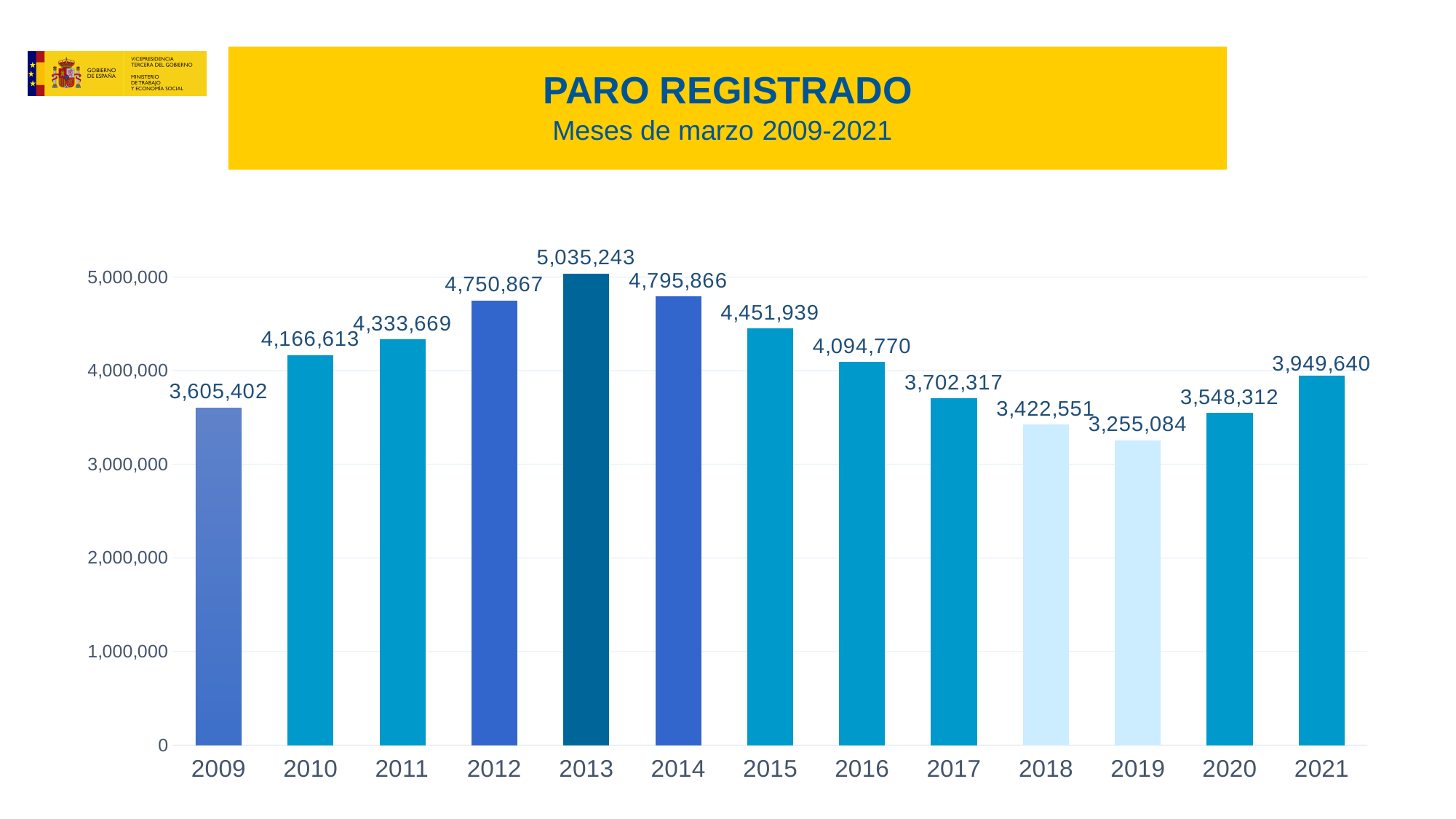
What is the difference between the values for 2021 and 2020? 401,328 Which year has the lowest value? 2019 Which is larger, the value for 2012 or the value for 2014? 2014 What is the difference between the values for 2013 and 2019? 1,780,159 How many years are shown on the x axis? 13 What is the value shown for 2009? 3,605,402 What is the registered unemployment value for 2013? 5,035,243 What is the value shown for 2021? 3,949,640 Which year has the highest value? 2013 Is the value for 2016 greater or less than 4,000,000? greater What kind of chart is shown on the slide? bar chart What is the title of the chart? PARO REGISTRADO